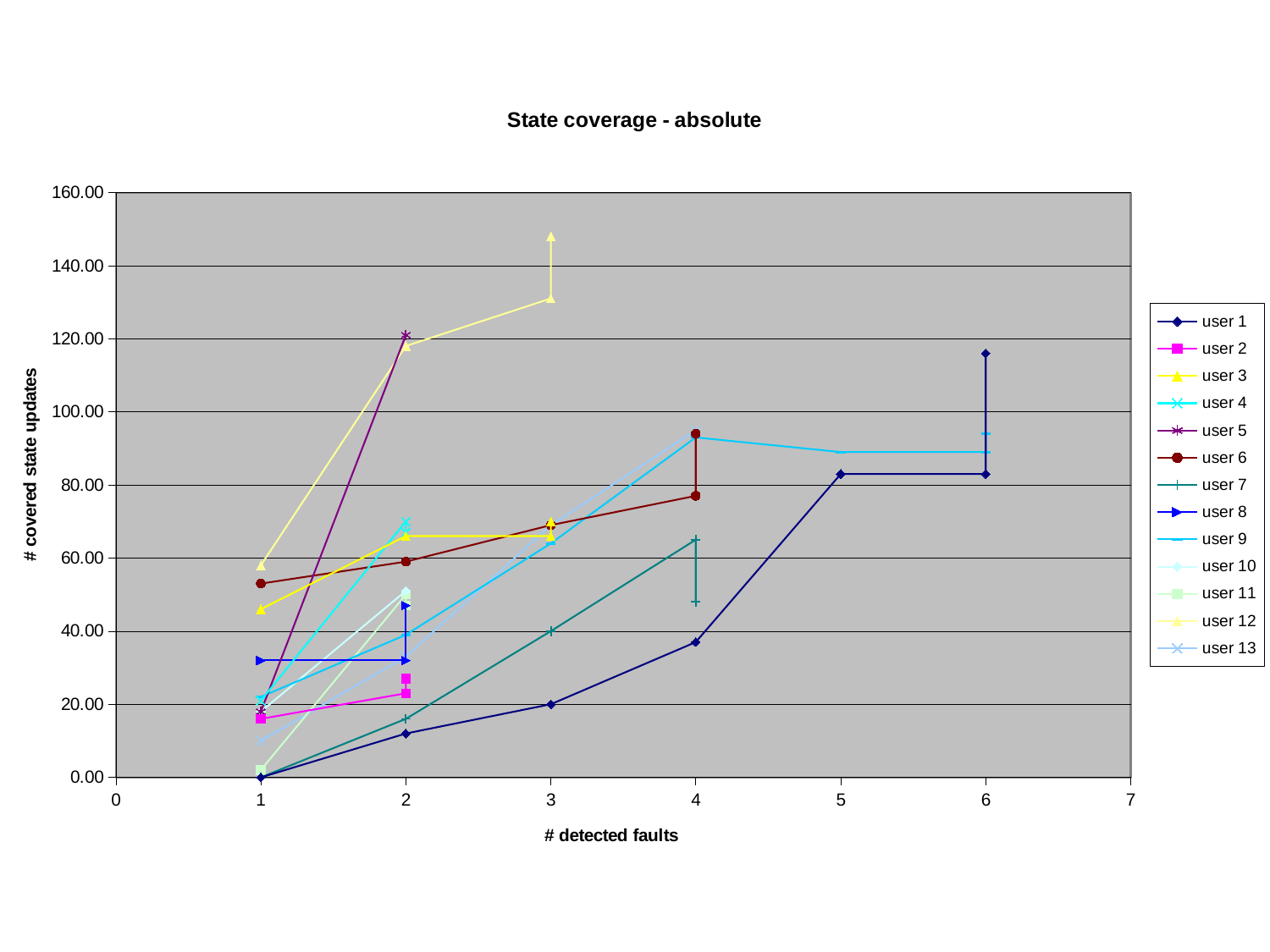
Does the value for user 1 rise or fall as the number of detected faults increases? rise Is the value for user 6 at 1 detected fault greater or less than 40.00? greater What is the title of the chart? State coverage - absolute Is the value for user 5 at 1 detected fault greater or less than 40.00? less Is the value for user 12 at 2 detected faults greater or less than 100.00? greater What is the label of the y axis? # covered state updates How many series does the legend list? 13 At 2 detected faults, which is larger: the value for user 12 or the value for user 6? user 12 What kind of chart is shown on the slide? line chart Which series reaches the highest value on the chart? user 12